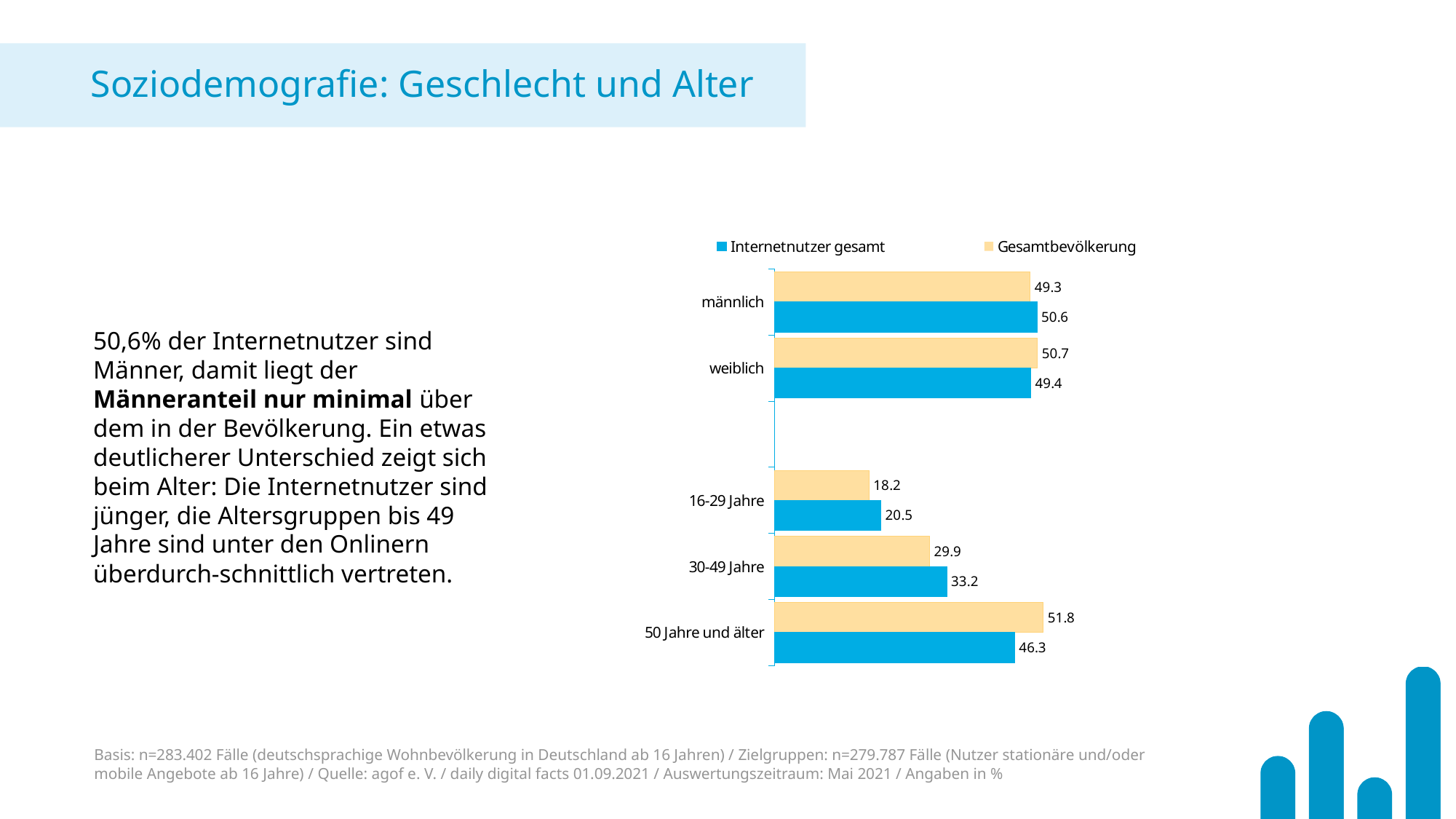
In the 16-29 Jahre category, which series has the larger value, Internetnutzer gesamt or Gesamtbevölkerung? Internetnutzer gesamt Which category has the highest value for Internetnutzer gesamt? männlich What is the difference between Gesamtbevölkerung and Internetnutzer gesamt in the 50 Jahre und älter category? 5.5 What is the value for Internetnutzer gesamt in the 16-29 Jahre category? 20.5 What is the value for Internetnutzer gesamt in the männlich category? 50.6 What is the value for Gesamtbevölkerung in the 50 Jahre und älter category? 51.8 Which colour represents the Gesamtbevölkerung series? Light yellow Which category has the lowest value for Gesamtbevölkerung? 16-29 Jahre What kind of chart is shown on the slide? Bar chart What is the value for Gesamtbevölkerung in the weiblich category? 50.7 What is the difference between Internetnutzer gesamt and Gesamtbevölkerung in the 30-49 Jahre category? 3.3 How many series does the legend list? 2